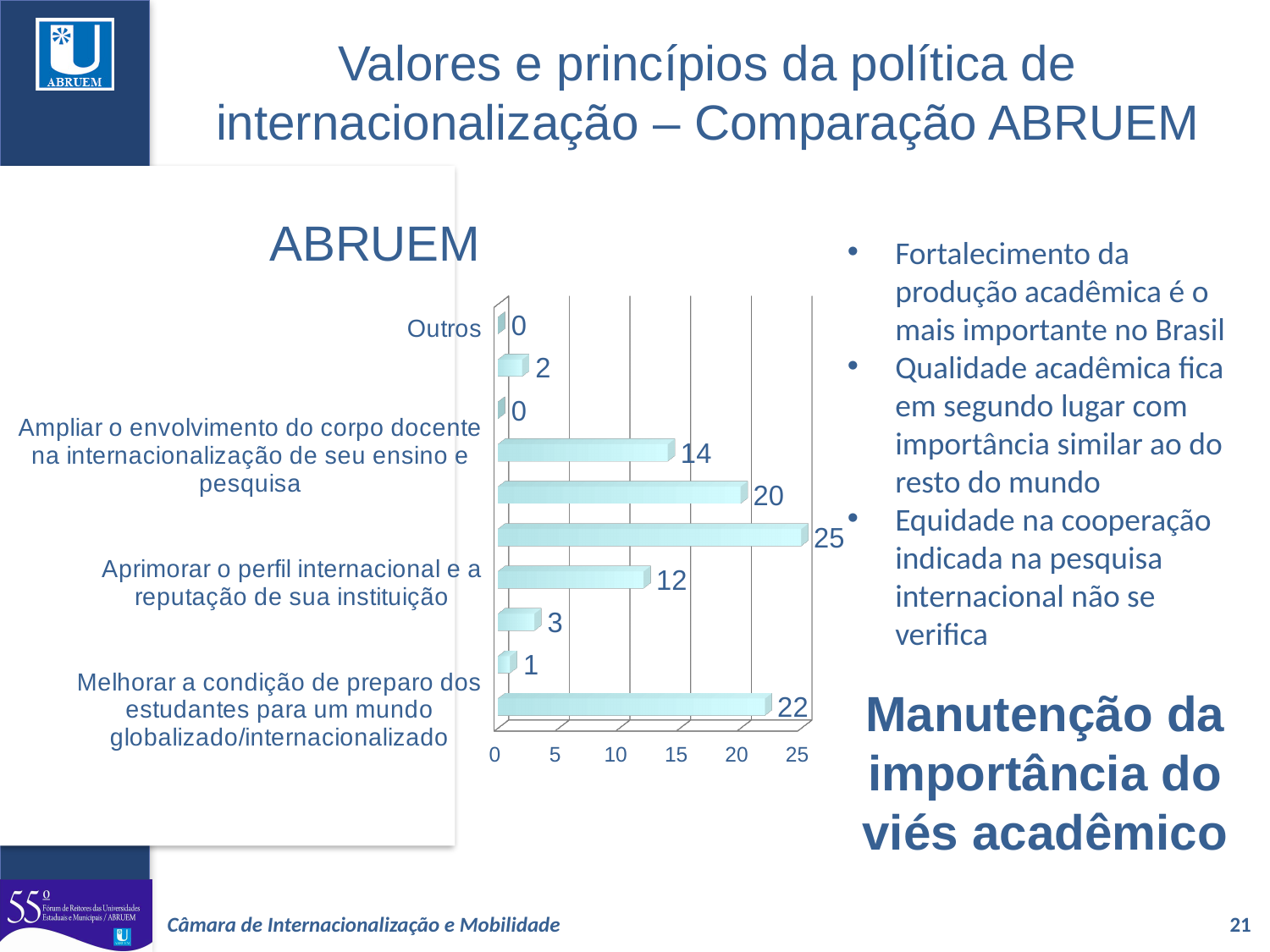
How many bars are plotted in the chart? 10 What is the value for "Aprimorar o perfil internacional e a reputação de sua instituição"? 12 What is the lowest value shown by any bar in the chart? 0 Is the value for "Melhorar a condição de preparo dos estudantes..." greater or less than 20? greater What kind of chart is shown on the slide? Bar chart What is the title of the chart? ABRUEM What is the value for "Ampliar o envolvimento do corpo docente na internacionalização de seu ensino e pesquisa"? 14 What is the value for "Melhorar a condição de preparo dos estudantes para um mundo globalizado/internacionalizado"? 22 What is the value for "Outros" in the ABRUEM chart? 0 What is the highest value shown by any bar in the chart? 25 Which has a larger value: "Ampliar o envolvimento do corpo docente..." or "Aprimorar o perfil internacional..."? Ampliar o envolvimento do corpo docente na internacionalização de seu ensino e pesquisa What is the difference between the value for "Melhorar a condição de preparo dos estudantes..." and the value for "Aprimorar o perfil internacional..."? 10